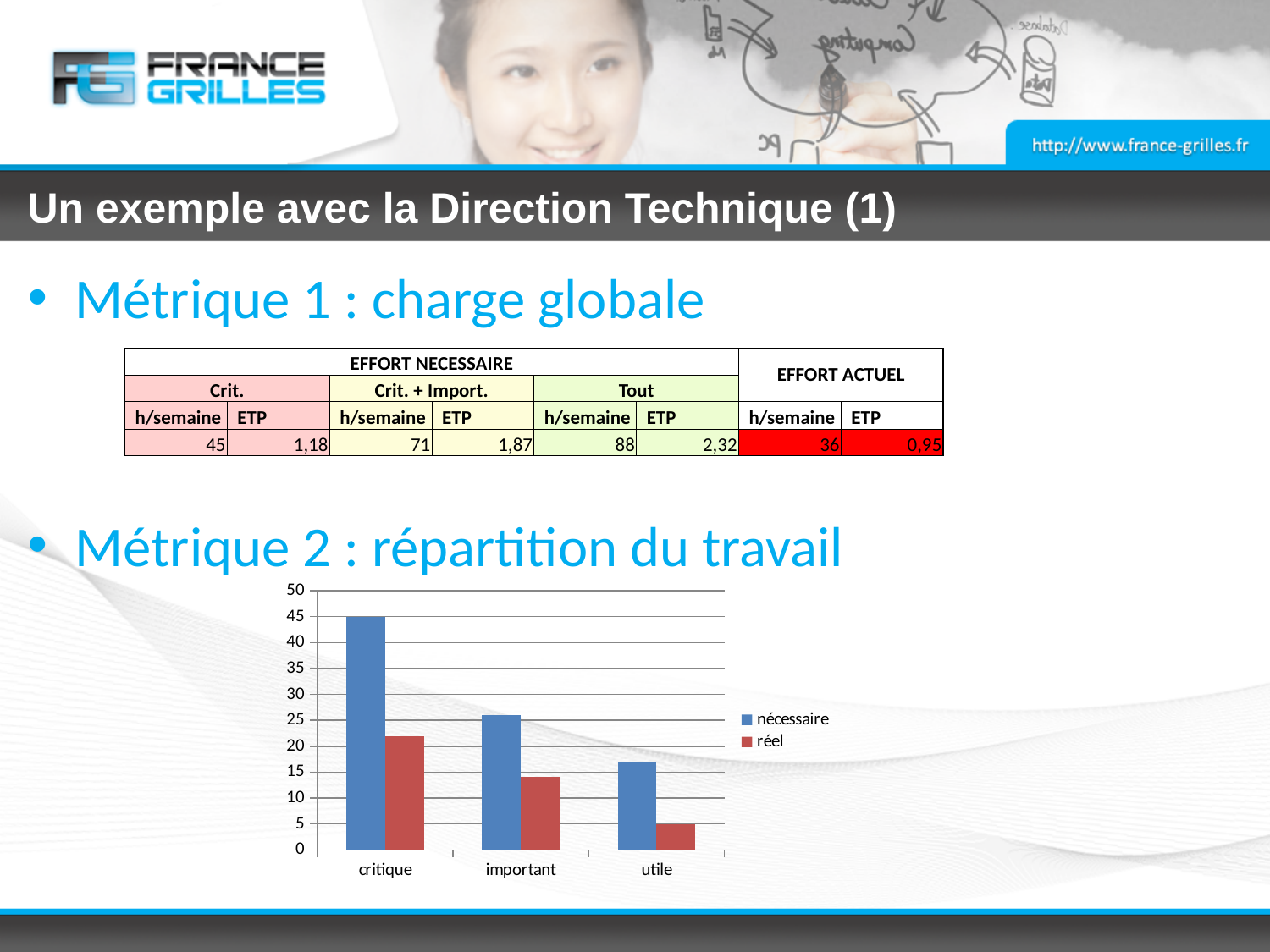
In the bar chart, is the "nécessaire" value for "utile" greater or less than 15? greater In the bar chart, which category has the highest "nécessaire" value? critique In the bar chart, what is the value of "réel" for "utile"? 5 In the bar chart, what is the value of "nécessaire" for "critique"? 45 In the bar chart, is the "nécessaire" value for "important" greater or less than 30? less What type of chart is shown under "Métrique 2 : répartition du travail"? bar chart In the bar chart, which is larger for "important": "nécessaire" or "réel"? nécessaire In the bar chart, which category has the lowest "réel" value? utile In the bar chart, is the "réel" value for "critique" greater or less than 20? greater In the bar chart, do the "nécessaire" values rise or fall from "critique" to "utile"? fall How many categories are shown on the x axis of the bar chart? 3 How many series does the legend of the bar chart list? 2